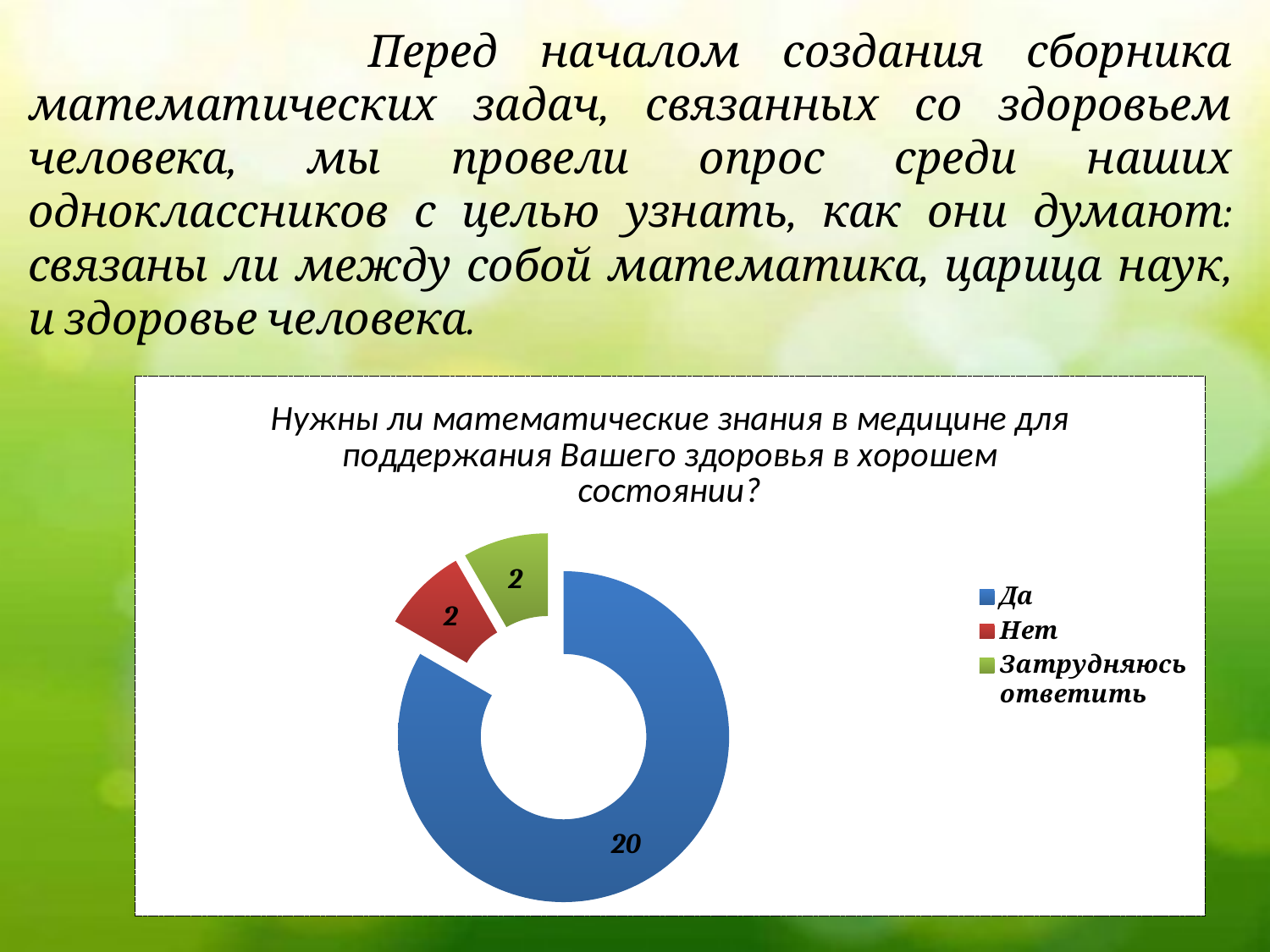
What is the difference between the values for "Да" and "Нет"? 18 What is the total of all the values in the chart? 24 What is the value for "Нет"? 2 How many categories does the chart show? 3 What colour is the "Да" slice? Blue What kind of chart is shown on the slide? Doughnut (pie) chart What is the value for "Да"? 20 What is the value for "Затрудняюсь ответить"? 2 Which category has the highest value? Да Which is larger, the value for "Да" or the value for "Затрудняюсь ответить"? Да How many entries does the legend list? 3